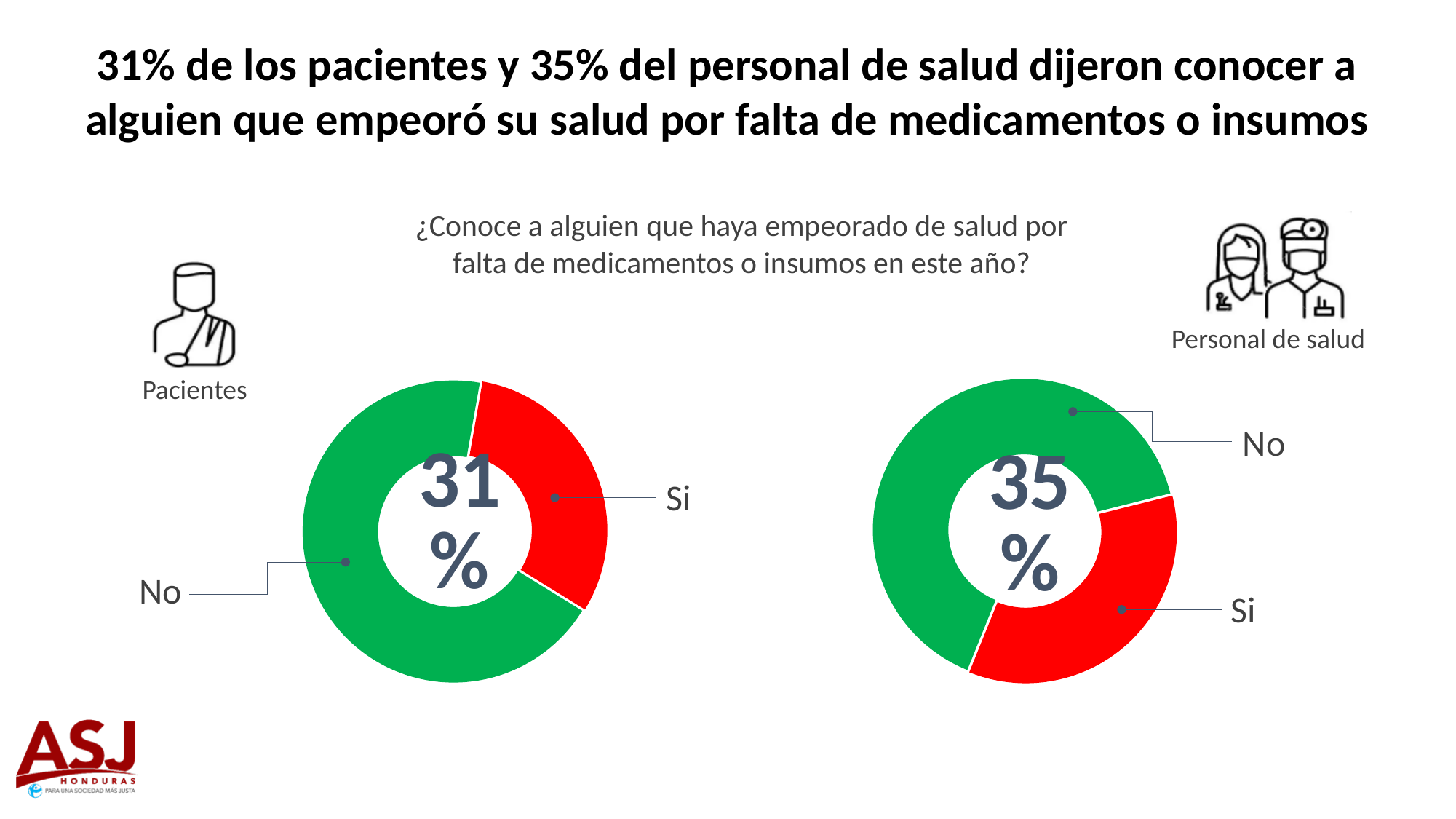
In the Personal de salud chart, which slice is larger, Si or No? No What kind of chart is used for the Pacientes data? Donut (pie) chart Which group has the larger share answering Si, Pacientes or Personal de salud? Personal de salud What is the difference between the Si share for Personal de salud and the Si share for Pacientes? 4 percentage points In the Pacientes chart, what percentage answered Si? 31% In the Personal de salud chart, what percentage answered Si? 35% How many slices does the Personal de salud chart have? 2 What question is shown as the title above the two charts? ¿Conoce a alguien que haya empeorado de salud por falta de medicamentos o insumos en este año? What are the two categories shown in the Pacientes chart? Si and No In the Pacientes chart, which slice is larger, Si or No? No What colour represents the Si slice in both charts? Red